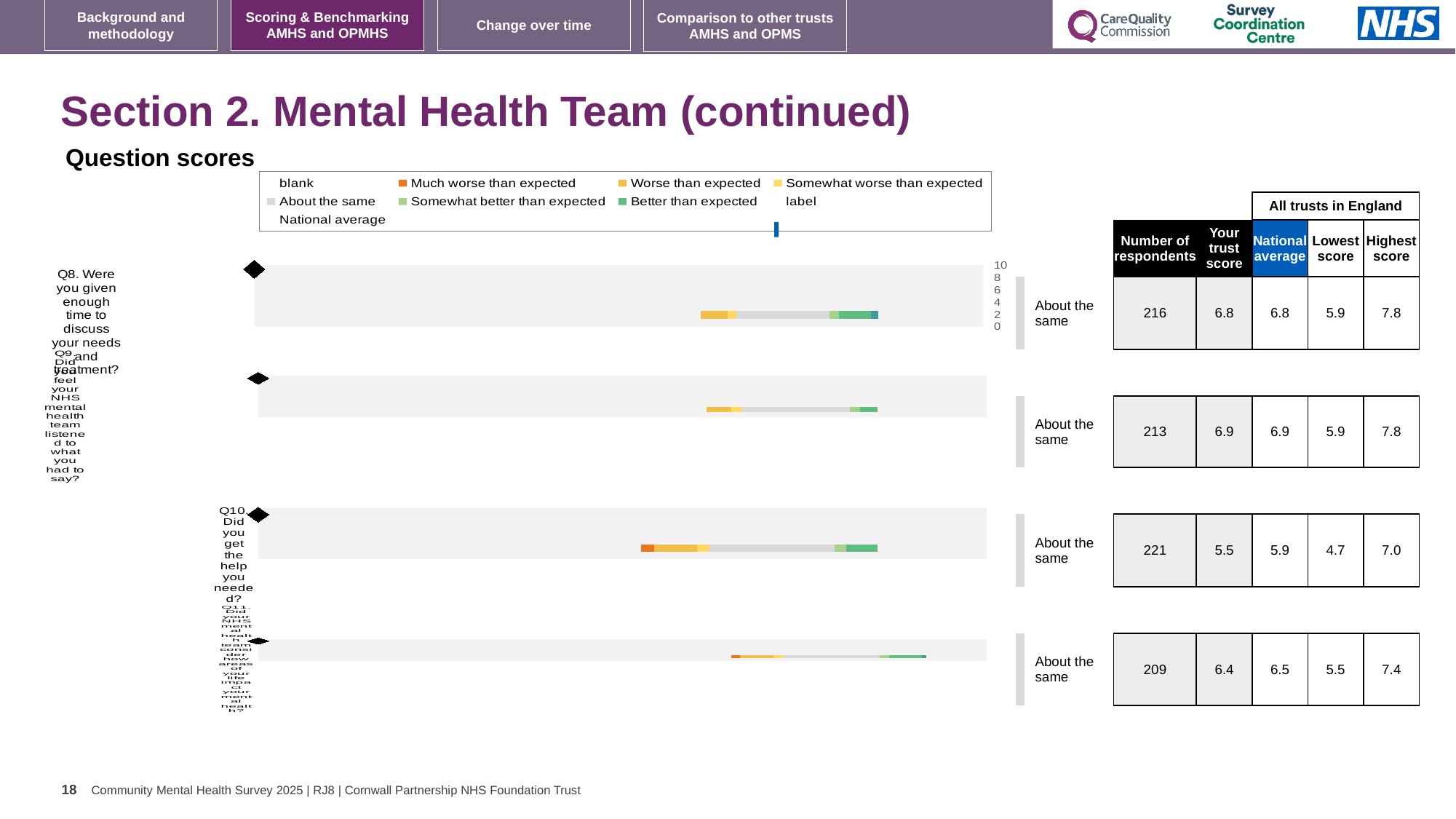
For Q10, what is the difference between the national average and the trust score? 0.4 What is the trust score for Q10 (Did you get the help you needed?)? 5.5 What is the lowest score across all trusts in England for Q10? 4.7 For Q11, which is larger: the trust score or the national average? National average What is the number of respondents for Q8? 216 Which question has the lowest trust score on this slide? Q10 What kind of chart is used to show the question scores on this slide? Bar chart Which question has the highest trust score on this slide? Q9 What benchmark category label is shown next to each of the four bars? About the same How many survey questions (bars) are plotted on this slide? 4 What is the highest score across all trusts in England for Q9? 7.8 What is the national average for Q11? 6.5